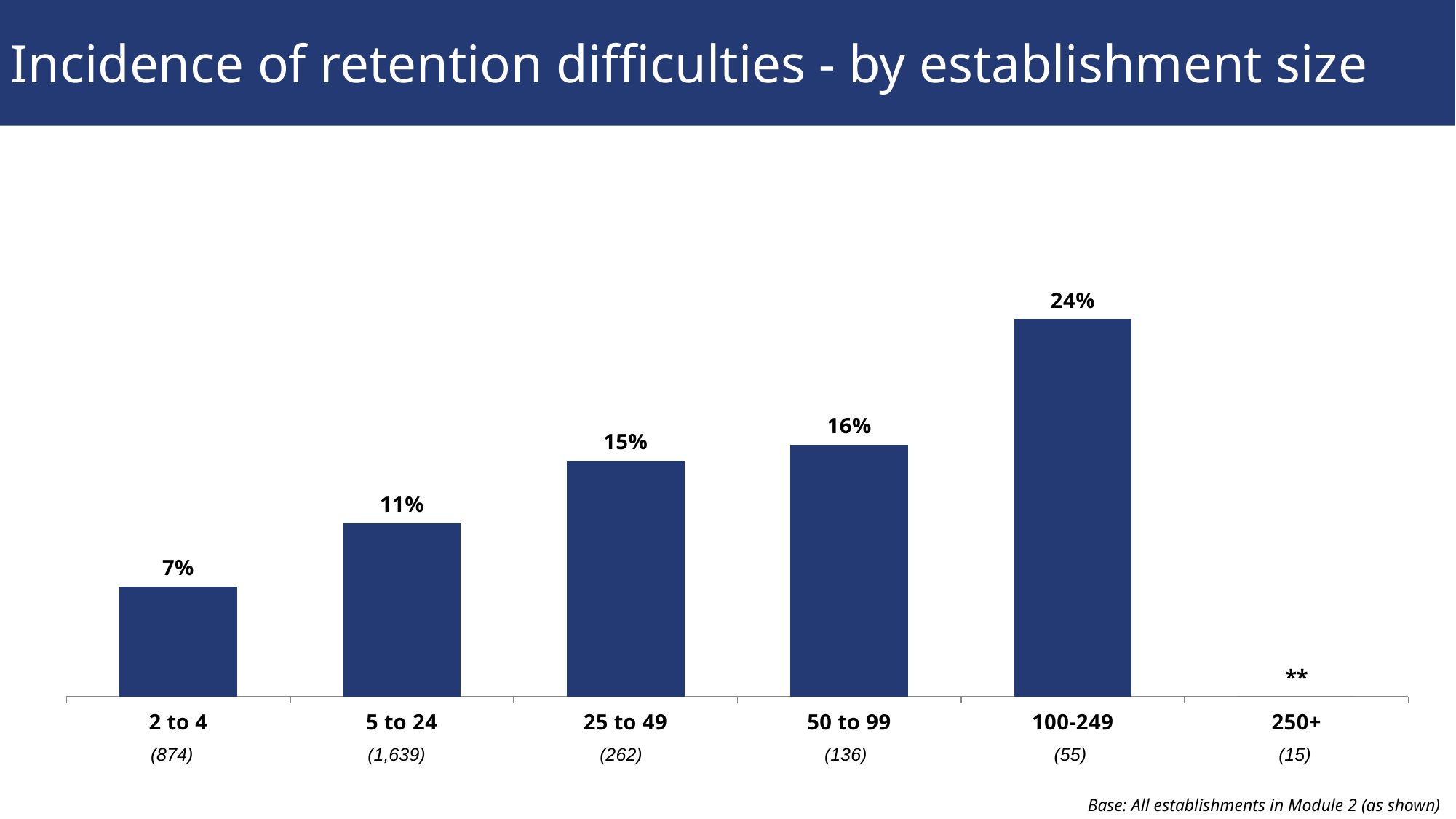
What is the base size shown for the 5 to 24 band? 1,639 What is the difference between the values for 100-249 and 50 to 99? 8% Which is larger, the value for 25 to 49 or the value for 5 to 24? 25 to 49 Among the size bands with a plotted value, which has the lowest incidence of retention difficulties? 2 to 4 What is the value for establishments with 100-249 employees? 24% What is the difference between the values for 5 to 24 and 2 to 4? 4% What is the value for establishments with 25 to 49 employees? 15% What kind of chart is shown on the slide? Bar chart Which establishment size band has the highest incidence of retention difficulties? 100-249 Do the values rise or fall from the 2 to 4 band to the 100-249 band? Rise How many establishment size bands are shown on the x axis? 6 What is the value for establishments with 2 to 4 employees? 7%